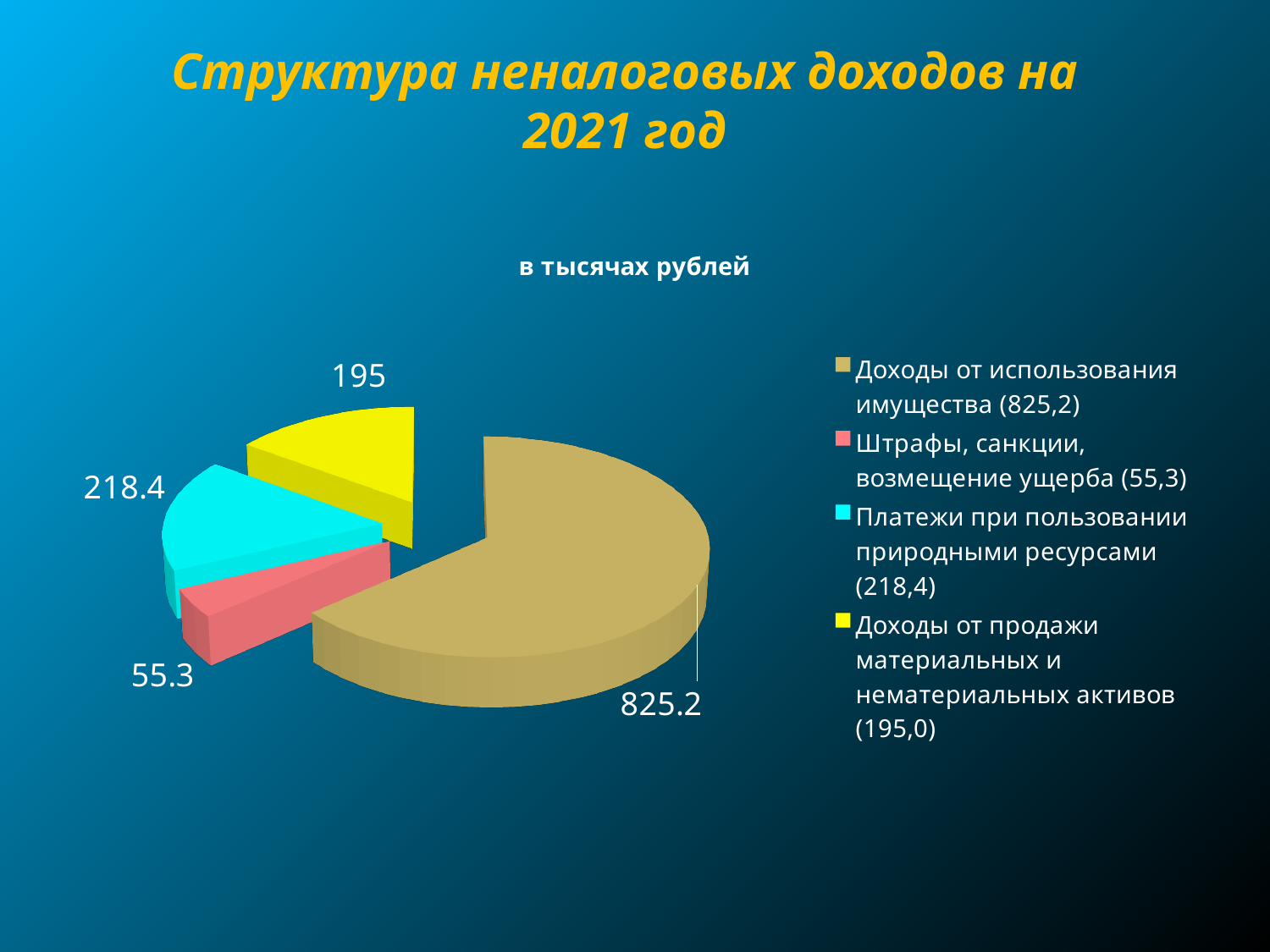
What is the value for Доходы от использования имущества? 825.2 What is the value for Штрафы, санкции, возмещение ущерба? 55.3 Which is larger: Платежи при пользовании природными ресурсами or Доходы от продажи материальных и нематериальных активов? Платежи при пользовании природными ресурсами What type of chart is shown on the slide? Pie chart What is the difference between the values for Доходы от использования имущества and Штрафы, санкции, возмещение ущерба? 769.9 What is the value for Платежи при пользовании природными ресурсами? 218.4 In what units are the values on the chart given, according to the chart subtitle? в тысячах рублей What share of the pie does Доходы от использования имущества represent? 63.8% Which category has the largest slice of the pie? Доходы от использования имущества What is the value for Доходы от продажи материальных и нематериальных активов? 195 How many slices does the pie chart have? 4 Which category has the smallest slice of the pie? Штрафы, санкции, возмещение ущерба